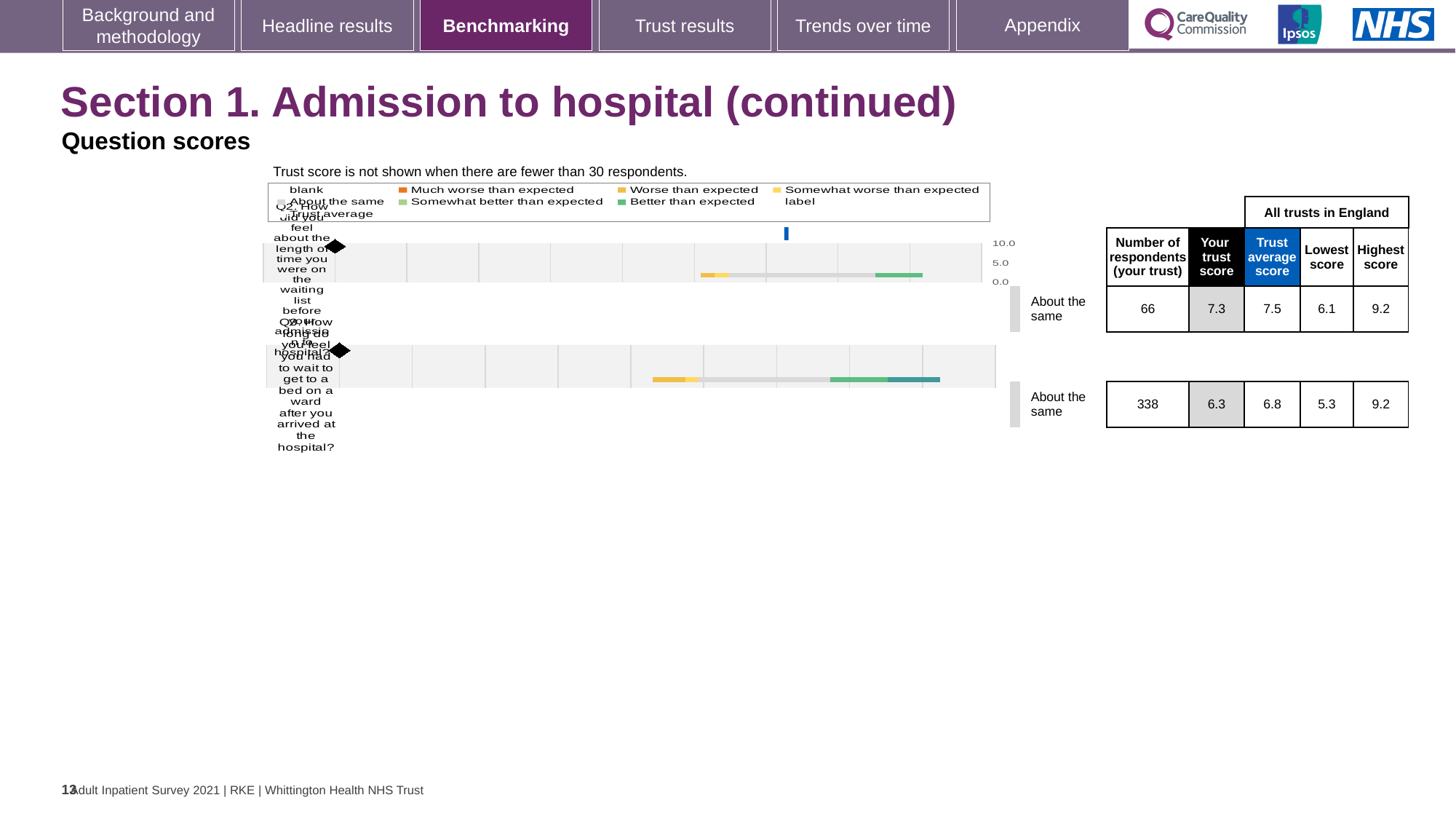
How many respondents from the trust answered Q3? 338 What is the trust score for Q3 (how long did you feel you had to wait to get to a bed on a ward after you arrived at the hospital)? 6.3 Is the trust score marker for Q2 greater or less than 5.0 on the axis? greater What is the lowest score across all trusts in England for Q2? 6.1 How many questions are plotted on the slide? 2 What kind of chart is used to show the question scores on this slide? bar chart What is the trust average score for Q2? 7.5 Which question has the higher trust score, Q2 or Q3? Q2 What is the trust score for Q2 (how did you feel about the length of time you were on the waiting list before admission)? 7.3 What is the benchmark category shown next to the Q2 chart? About the same What is the highest score across all trusts in England for Q3? 9.2 What is the difference between the trust average score and the trust score for Q3? 0.5